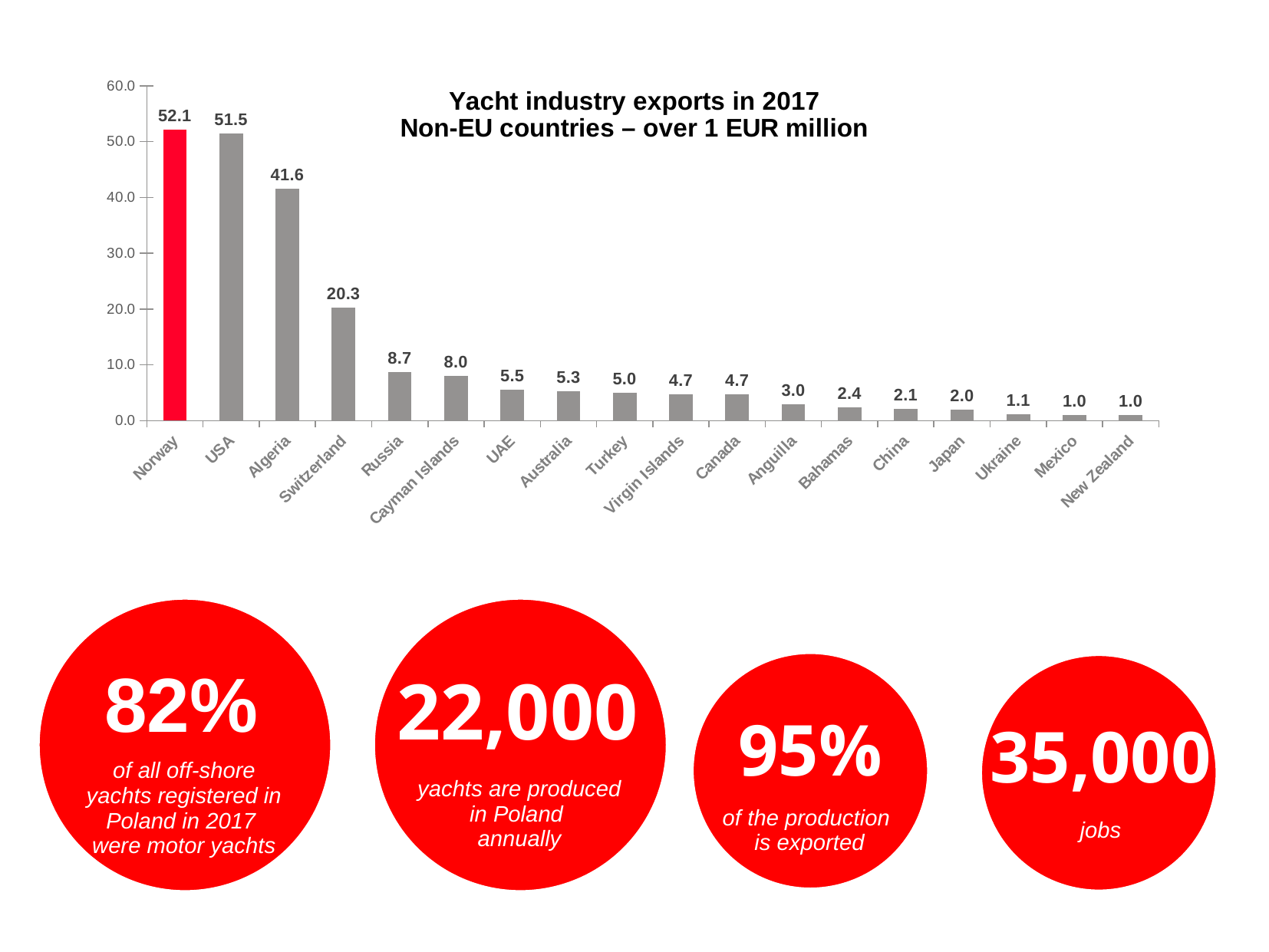
What is the value for Algeria in the chart? 41.6 Which country has the highest value in the chart? Norway What is the value for Japan in the chart? 2.0 How many countries are shown in the chart? 18 What is the difference between the values for Russia and Cayman Islands? 0.7 What is the difference between the values for Norway and USA? 0.6 What is the value for Switzerland in the yacht industry exports chart? 20.3 Which bar in the chart is highlighted in red? Norway Which has a larger value, Algeria or Switzerland? Algeria What is the value for Cayman Islands in the chart? 8.0 What type of chart is shown on the slide? bar chart Is the value for Switzerland greater or less than 30.0? less